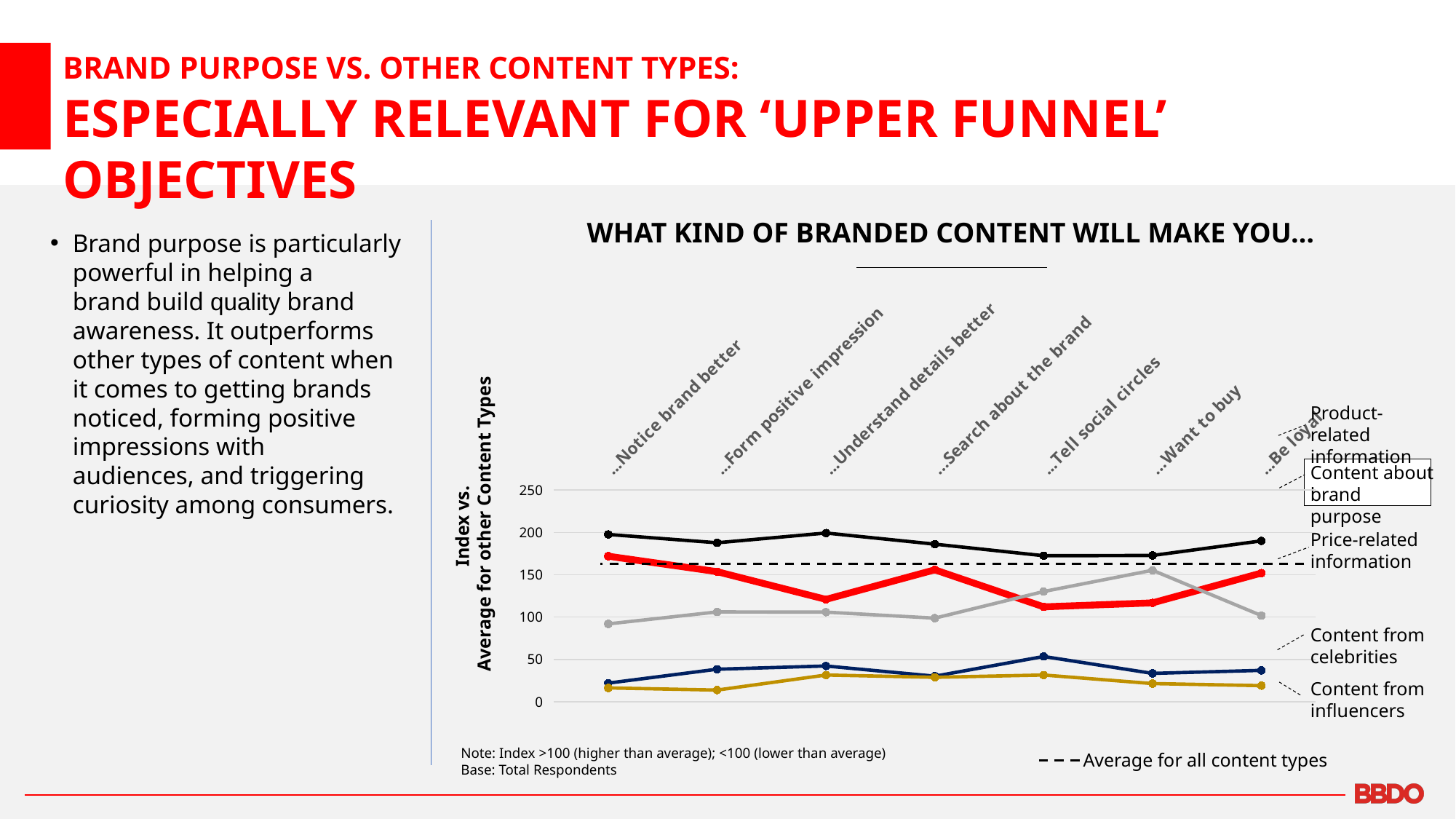
What is the title of the chart? WHAT KIND OF BRANDED CONTENT WILL MAKE YOU... Is the value for Product-related information at 'Notice brand better' greater or less than 150? greater Is the value for Content about brand purpose at 'Understand details better' greater or less than 150? less What kind of chart is shown on the slide? Line chart How many content-type series (excluding the dashed average line) are plotted in the chart? 5 Which series has the highest value at 'Notice brand better'? Product-related information At 'Want to buy', which is higher: Price-related information or Content about brand purpose? Price-related information Is the value for Content from influencers at 'Notice brand better' greater or less than 50? less How many categories are shown along the x axis of the chart? 7 Which series has the lowest value at 'Notice brand better'? Content from influencers What does the dashed horizontal line in the chart represent? Average for all content types Does the Content about brand purpose line rise or fall from 'Notice brand better' to 'Understand details better'? Fall